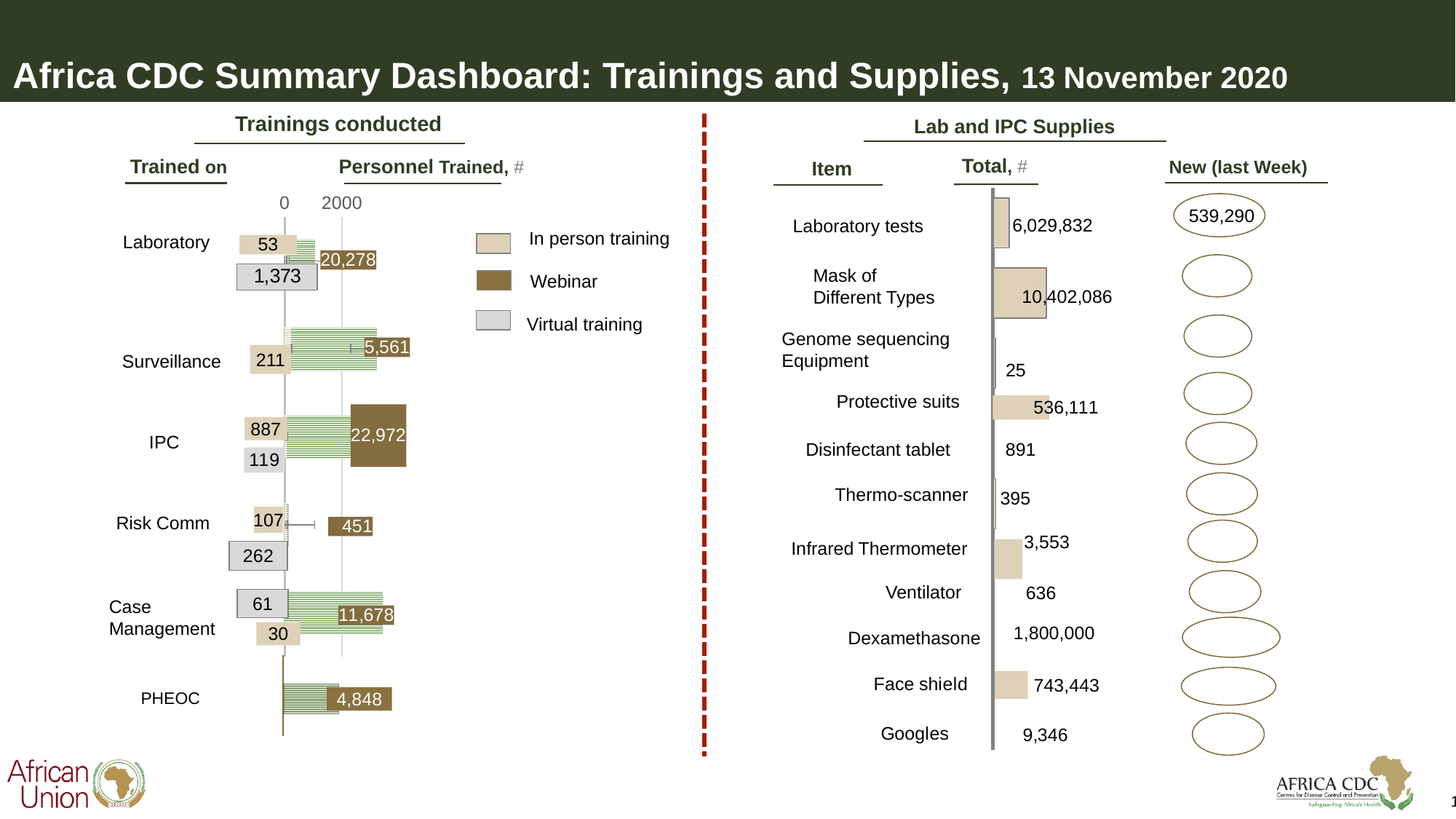
In the Trainings conducted chart, which training topic has the highest number of personnel trained via webinar? IPC How many series does the legend of the Trainings conducted chart list? 3 How many training topics are shown in the Trainings conducted chart? 6 In the Trainings conducted chart, how many personnel received virtual training on Laboratory? 1,373 In the Trainings conducted chart, what is the difference between the webinar values for IPC and Laboratory? 2,694 In the Lab and IPC Supplies chart, what is the total for Mask of Different Types? 10,402,086 In the Trainings conducted chart, which has more in-person training personnel: Surveillance or IPC? IPC In the Lab and IPC Supplies chart, which item has the highest total? Mask of Different Types In the Lab and IPC Supplies chart, which item has the lowest total? Genome sequencing Equipment In the Trainings conducted chart, how many personnel were trained on IPC via webinar? 22,972 In the Lab and IPC Supplies chart, what is the New (last Week) value for Laboratory tests? 539,290 In the Trainings conducted chart, which training topic has the lowest number of personnel trained via webinar? Risk Comm